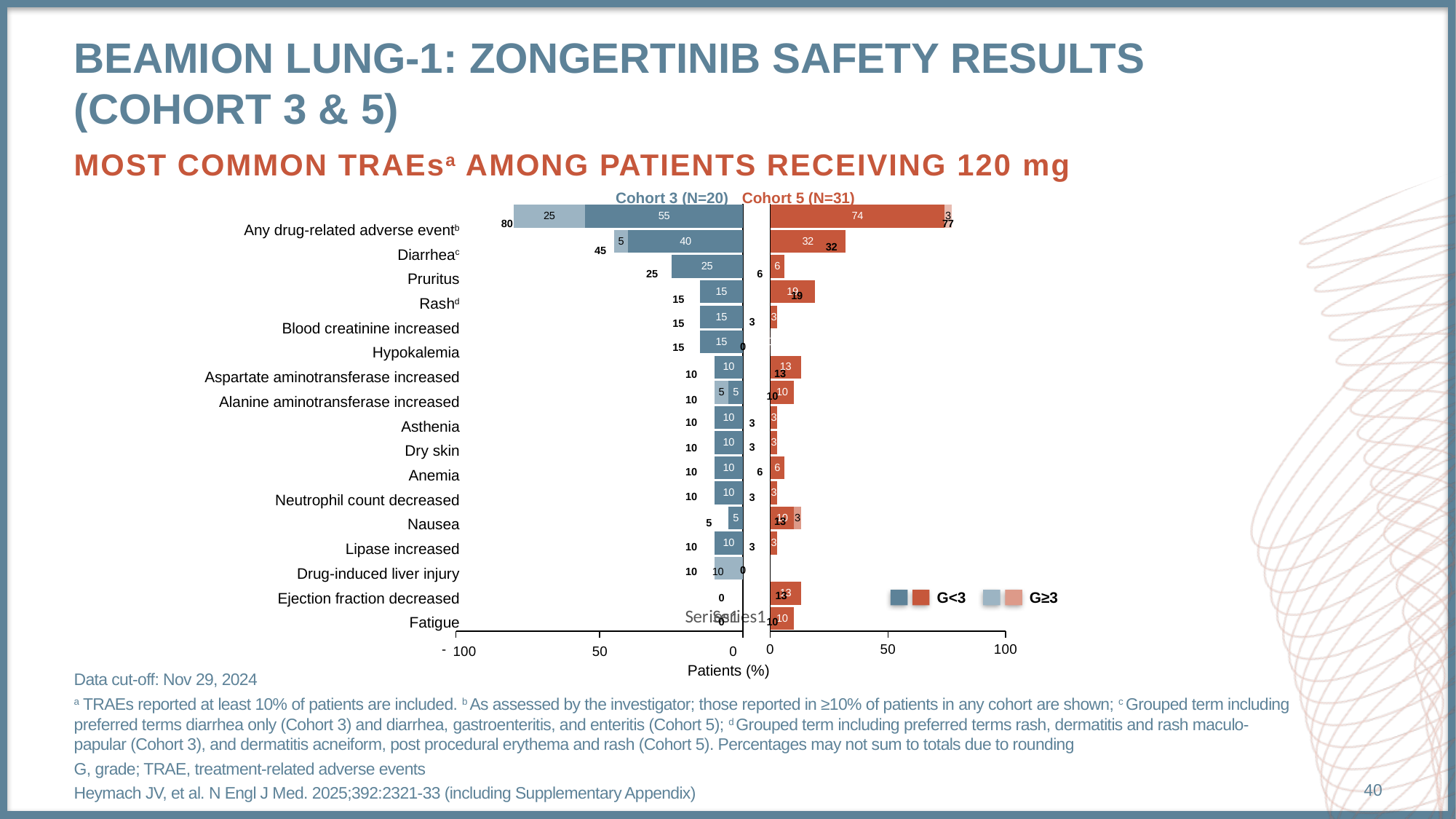
What kind of chart is shown on the slide? bar chart Which cohort has the higher percentage of patients with pruritus, Cohort 3 or Cohort 5? Cohort 3 What is the difference between the diarrhea percentages in Cohort 3 and Cohort 5? 13 In Cohort 3, what is the G<3 value for diarrhea? 40 What is the total percentage of patients with any drug-related adverse event in Cohort 5? 77 What percentage of Cohort 5 patients had diarrhea? 32 What percentage of Cohort 3 patients had pruritus? 25 What are the two grade groups shown in the legend? G<3 and G≥3 What is the total percentage of patients with any drug-related adverse event in Cohort 3? 80 How many adverse event categories are listed on the chart? 17 What percentage of Cohort 5 patients had rash? 19 In Cohort 5, what is the G≥3 value for any drug-related adverse event? 3